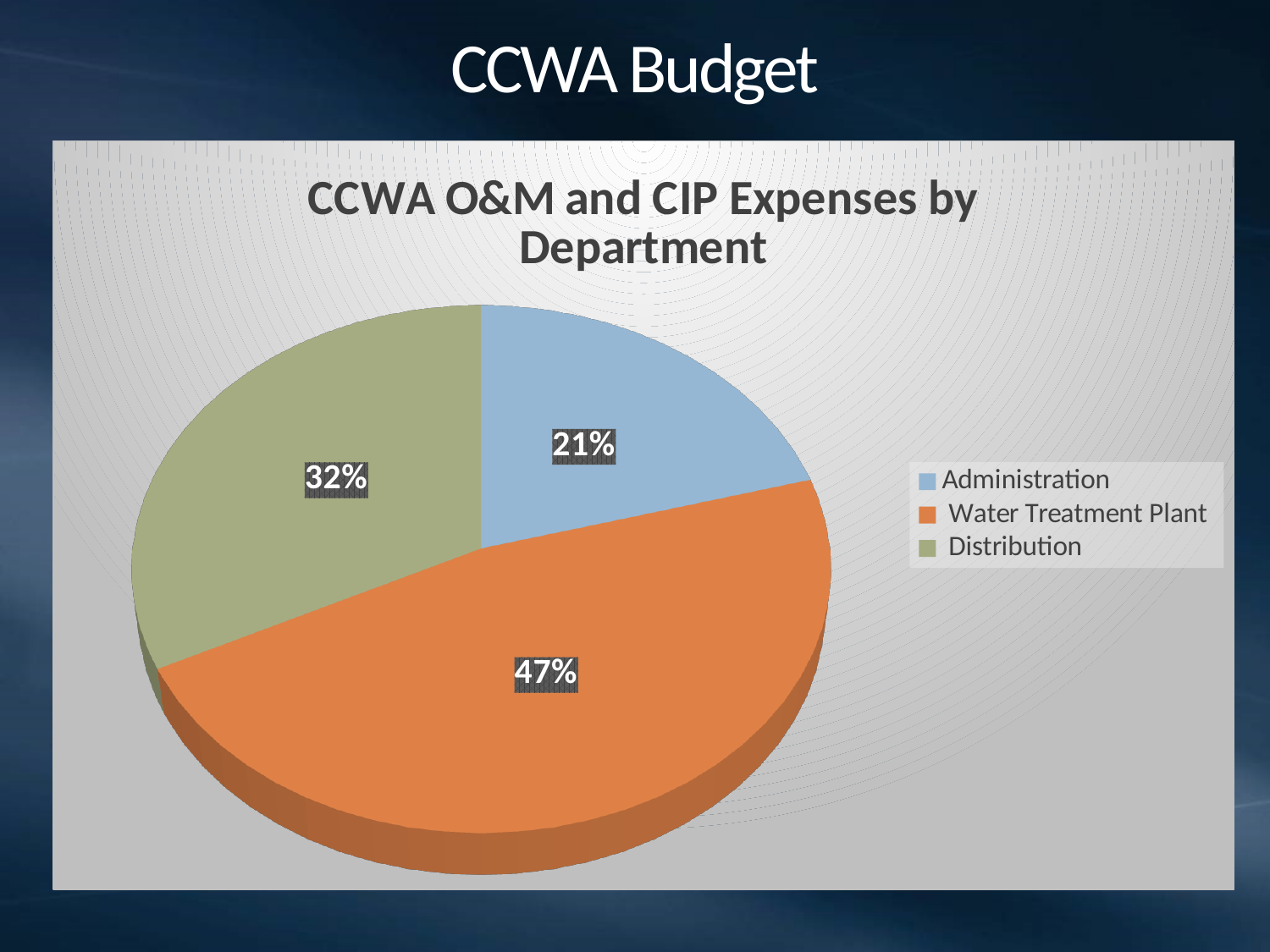
What is the title of the chart? CCWA O&M and CIP Expenses by Department What kind of chart is shown on the slide? Pie chart Which has a larger share, Distribution or Administration? Distribution How many entries does the legend list? 3 What is the difference in percentage points between the Water Treatment Plant share and the Distribution share? 15 percentage points What share of expenses does the Water Treatment Plant account for? 47% How many departments are shown in the pie chart? 3 Which department has the largest share of expenses? Water Treatment Plant What share of expenses does Distribution account for? 32% What share of expenses does Administration account for? 21% Which department has the smallest share of expenses? Administration What colour represents the Water Treatment Plant slice? Orange